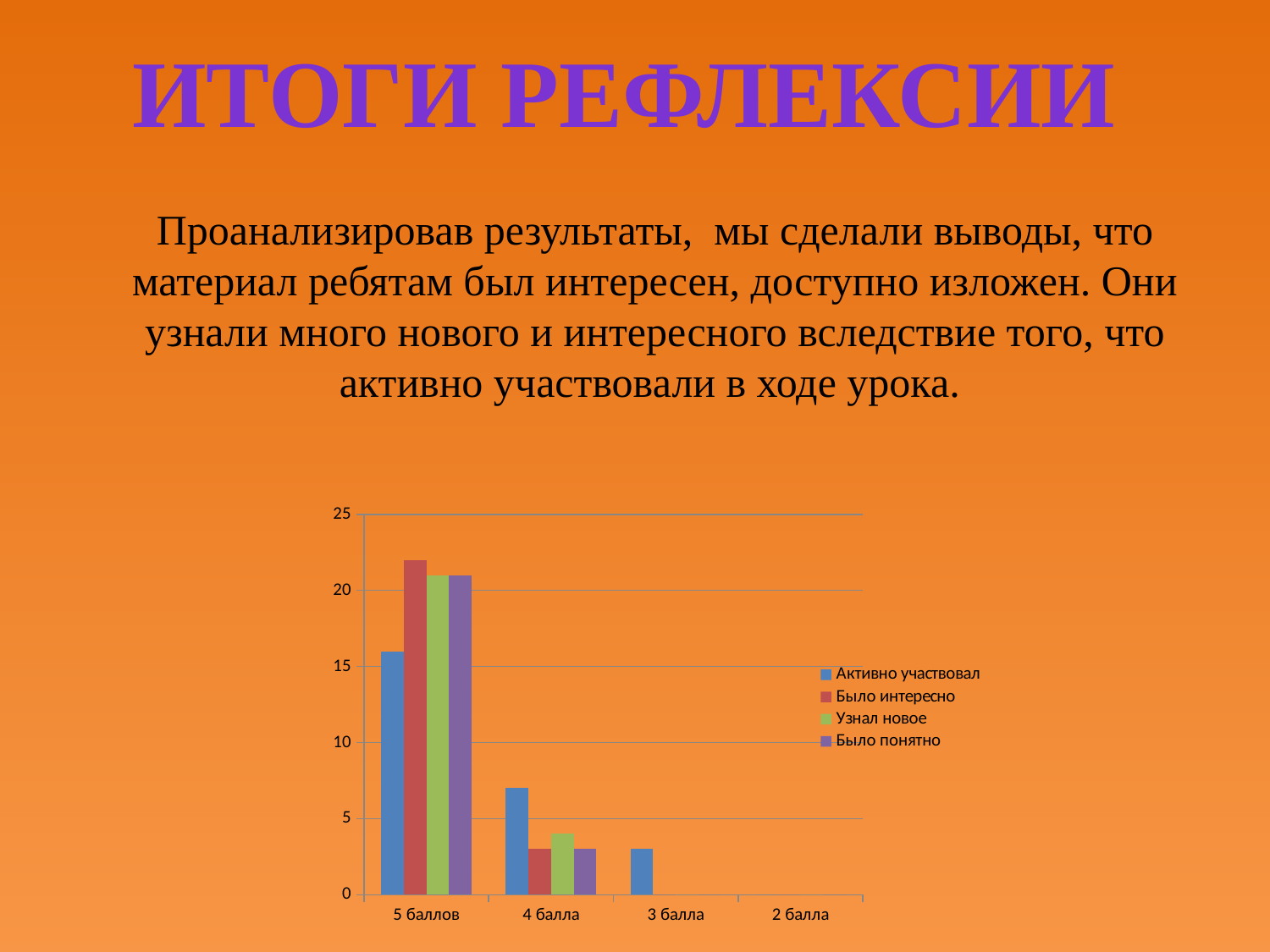
At "5 баллов", which series has the larger value: "Активно участвовал" or "Было интересно"? Было интересно Is the value for "Было интересно" at "4 балла" greater or less than 5? less Is the value for "Было интересно" at "5 баллов" greater or less than 20? greater Which category has the lowest values across all series in the chart? 2 балла What kind of chart is shown on the slide? bar chart How many series does the chart's legend list? 4 Is the value for "Активно участвовал" at "4 балла" greater or less than 5? greater Which category has the highest value for the series "Активно участвовал"? 5 баллов How many categories are shown on the x axis of the chart? 4 Do the values for "Активно участвовал" rise or fall from "5 баллов" to "2 балла"? fall Which series is listed first in the chart's legend? Активно участвовал